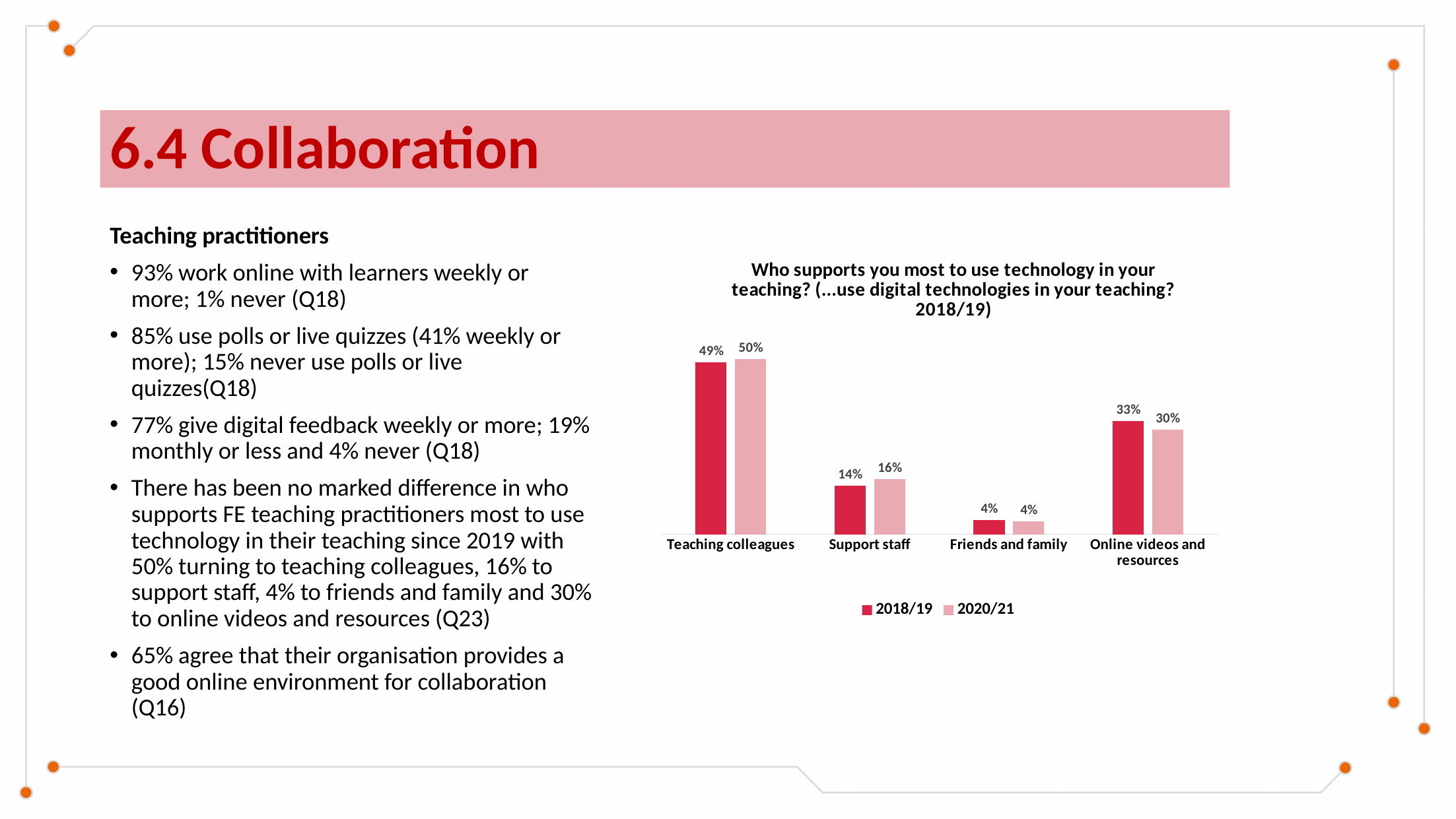
What is the difference between the 2020/21 values for Teaching colleagues and Support staff? 34% Which is larger for Support staff, the 2018/19 value or the 2020/21 value? 2020/21 What is the 2018/19 value for Online videos and resources? 33% How many series does the legend list? 2 Which category has the lowest 2020/21 value? Friends and family What is the 2020/21 value for Teaching colleagues? 50% How many categories are shown on the x axis? 4 What is the 2020/21 value for Support staff? 16% Which category has the highest 2018/19 value? Teaching colleagues What is the difference between the 2018/19 and 2020/21 values for Online videos and resources? 3% What are the two series named in the legend? 2018/19 and 2020/21 What kind of chart is shown on the slide? Bar chart